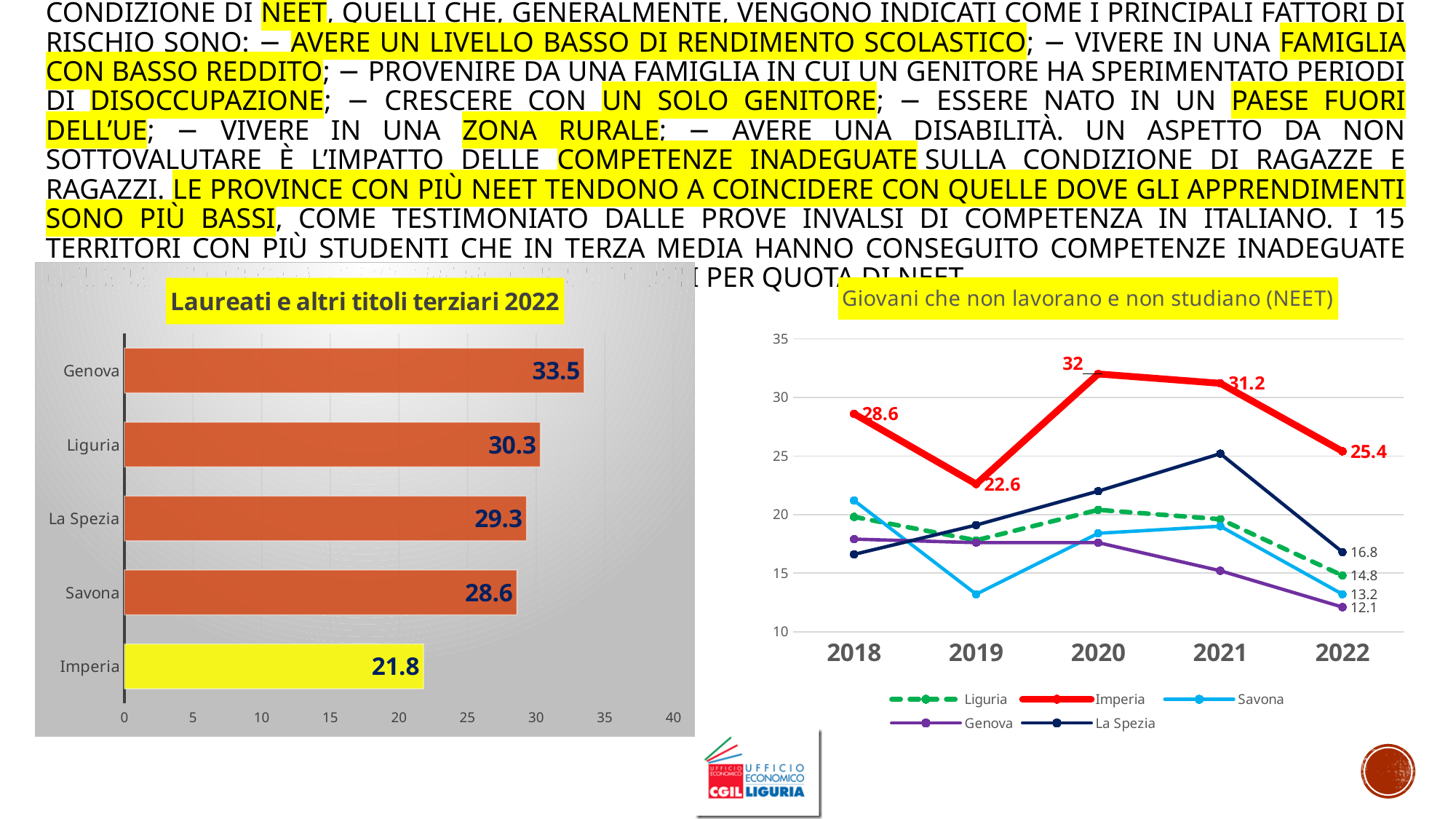
In the 'Laureati e altri titoli terziari 2022' chart, how many categories are shown? 5 In the 'Giovani che non lavorano e non studiano (NEET)' chart, how many series does the legend list? 5 In the 'Laureati e altri titoli terziari 2022' chart, what is the difference between Genova and Imperia? 11.7 In the 'Laureati e altri titoli terziari 2022' chart, which category has the lowest value? Imperia What kind of chart is 'Laureati e altri titoli terziari 2022'? Bar chart In the 'Giovani che non lavorano e non studiano (NEET)' chart, what is the difference between Imperia's value in 2020 and in 2022? 6.6 In the 'Giovani che non lavorano e non studiano (NEET)' chart, which series is drawn with a dashed green line? Liguria In the 'Giovani che non lavorano e non studiano (NEET)' chart, is the value for Savona in 2019 greater or less than 15? less In the 'Giovani che non lavorano e non studiano (NEET)' chart, what is the value for Imperia in 2020? 32 In the 'Laureati e altri titoli terziari 2022' chart, what is the value for Genova? 33.5 In the 'Laureati e altri titoli terziari 2022' chart, which is larger, La Spezia or Savona? La Spezia In the 'Giovani che non lavorano e non studiano (NEET)' chart, what is the value for Genova in 2022? 12.1